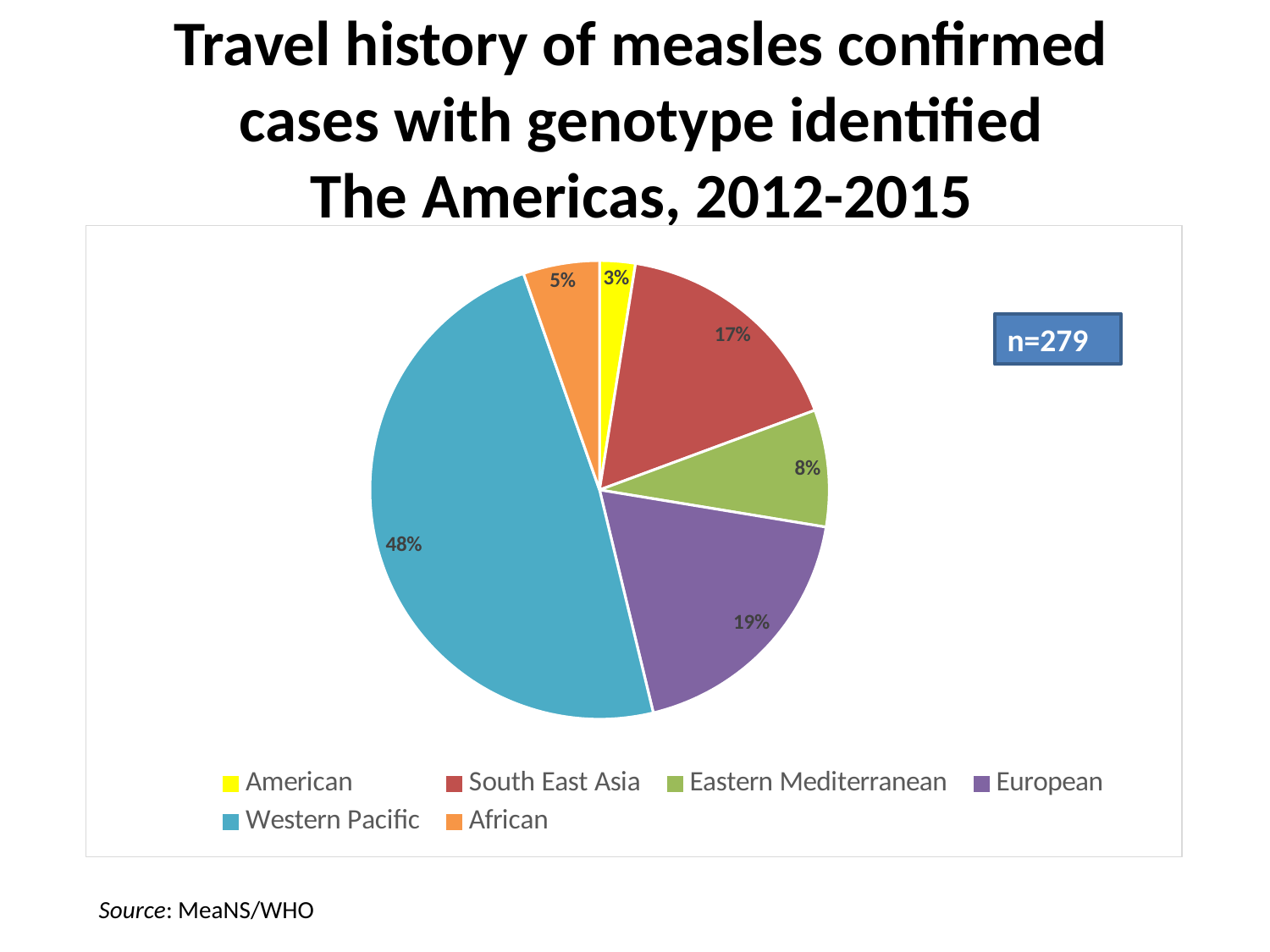
What is the value shown for the Eastern Mediterranean slice? 8% What is the total number of cases (n) stated on the chart? 279 Which region has the largest slice of the pie? Western Pacific Which region has the smallest slice of the pie? American What share of the pie does Western Pacific account for? 48% How many regions are shown in the pie chart? 6 What is the value shown for the African slice? 5% What is the value shown for the South East Asia slice? 17% What is the value shown for the European slice? 19% Which slice is larger, Eastern Mediterranean or African? Eastern Mediterranean What is the difference in percentage points between the European and South East Asia slices? 2 What kind of chart is shown on the slide? pie chart